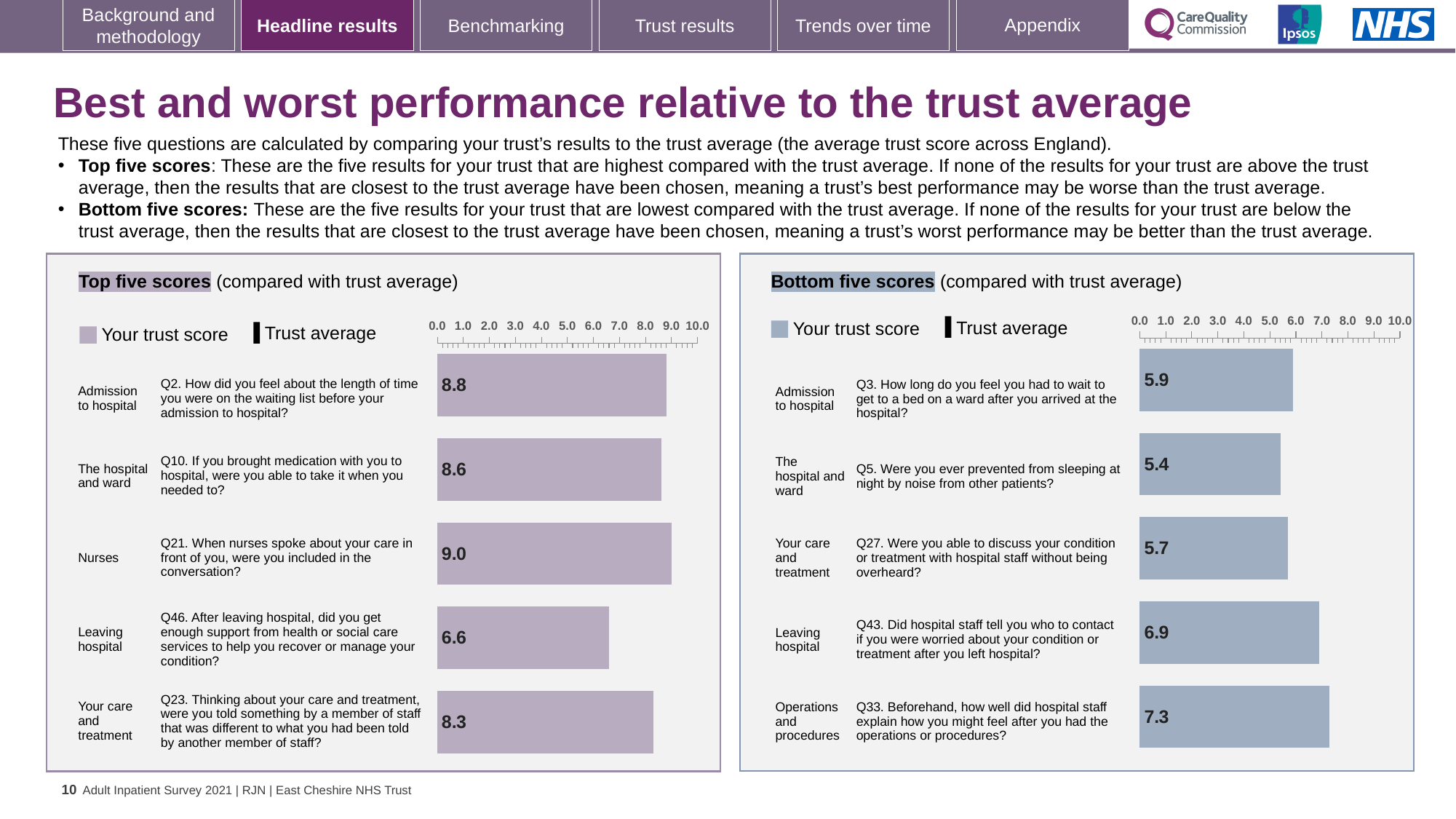
In the Bottom five scores chart, what is the trust score for Q43 (Leaving hospital)? 6.9 In the Bottom five scores chart, which has the larger score, Q3 or Q27? Q3 In the Top five scores chart, what is the difference between the scores for Q2 and Q10? 0.2 In the Bottom five scores chart, what is the difference between the scores for Q33 and Q5? 1.9 In the Bottom five scores chart, which question has the lowest trust score? Q5 (The hospital and ward) In the Top five scores chart, which question has the highest trust score? Q21 (Nurses) How many bars are plotted in the Top five scores chart? 5 In the Bottom five scores chart, what is the trust score for Q5 about being prevented from sleeping by noise from other patients? 5.4 In the Top five scores chart, which question has the lowest trust score? Q46 (Leaving hospital) What type of chart is used in the Bottom five scores panel? Bar chart In the Top five scores chart, what is the trust score for Q21 (Nurses)? 9.0 In the Bottom five scores chart, which question has the highest trust score? Q33 (Operations and procedures)